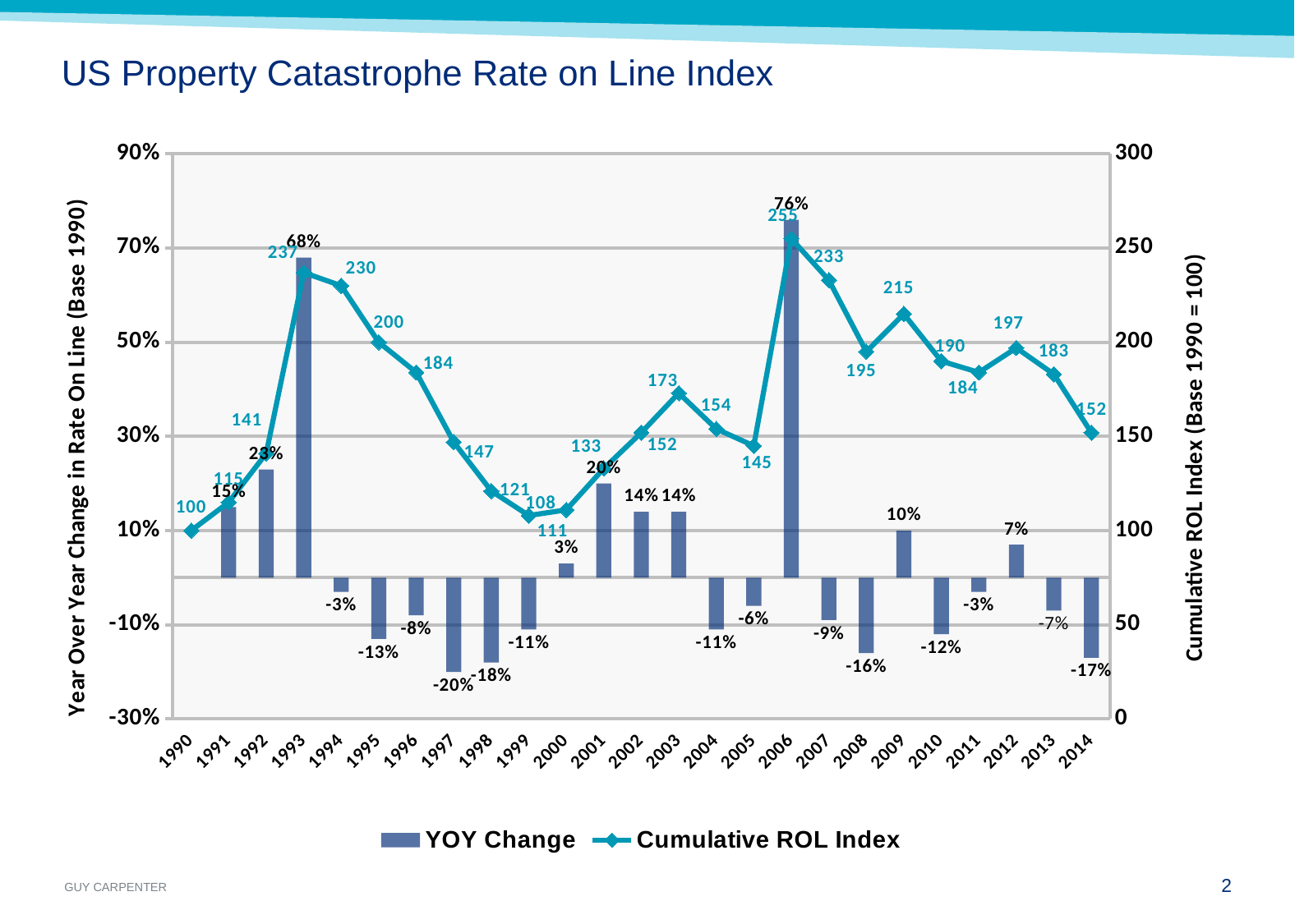
How many years are shown on the x axis? 25 What is the YOY Change for 1993? 68% What is the difference between the Cumulative ROL Index values for 2006 and 2007? 22 Does the Cumulative ROL Index rise or fall from 2012 to 2014? fall What is the Cumulative ROL Index value for 2006? 255 Which year has the highest Cumulative ROL Index value? 2006 Which is larger, the Cumulative ROL Index for 1993 or for 2007? 1993 Which year has the lowest YOY Change? 1997 What is the YOY Change for 2008? -16% Which year has the highest YOY Change? 2006 How many series does the legend list? 2 What is the Cumulative ROL Index value for 2014? 152